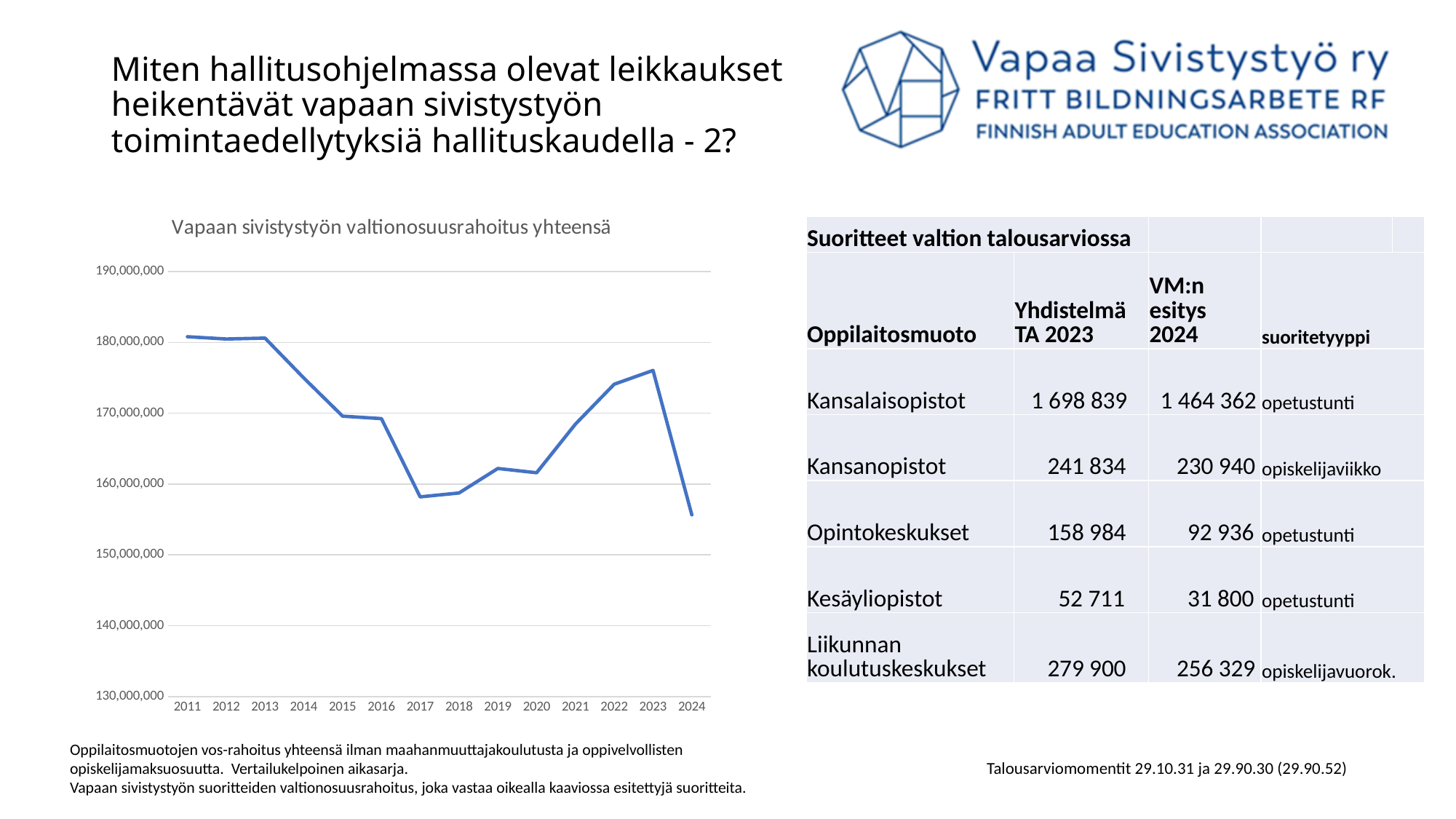
Does the value rise or fall from 2020 to 2023? rise Is the value for 2014 greater or less than 170,000,000? greater How many years are plotted on the x axis of the chart? 14 Which year has the larger value, 2023 or 2024? 2023 Which year has the larger value, 2015 or 2017? 2015 What is the title of the chart? Vapaan sivistystyön valtionosuusrahoitus yhteensä Does the value rise or fall from 2013 to 2017? fall What kind of chart is shown on the slide? line chart Is the value for 2024 greater or less than 160,000,000? less Which year has the lowest value in the chart? 2024 Is the value for 2017 greater or less than 160,000,000? less